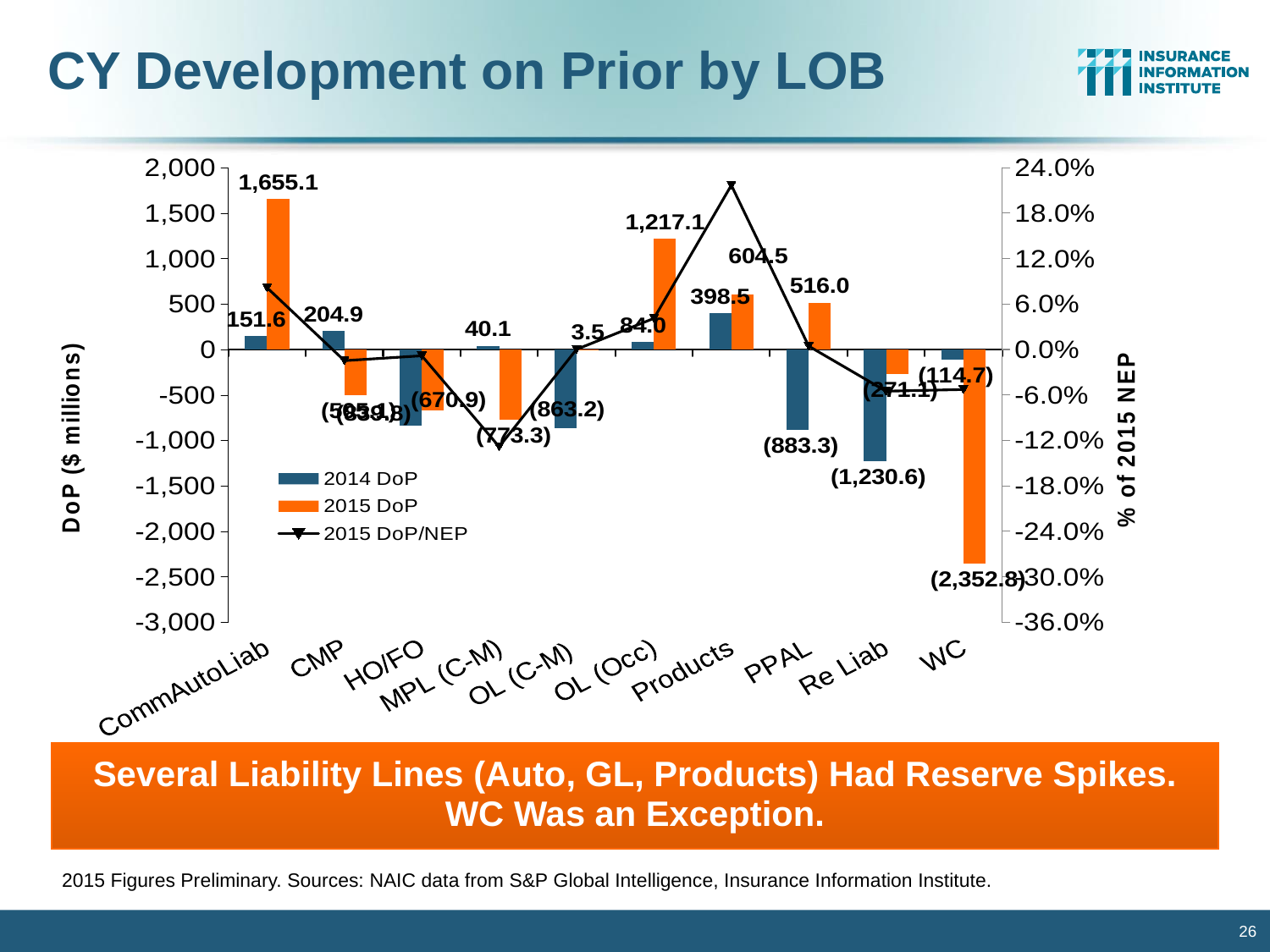
What is the 2014 DoP value for Re Liab? (1,230.6) What is the 2015 DoP value for OL (Occ)? 1,217.1 What is the difference between the 2015 DoP for CommAutoLiab and for OL (Occ)? 438.0 Which line of business has the highest 2015 DoP? CommAutoLiab What is the 2015 DoP value for CommAutoLiab? 1,655.1 Which line of business has the lowest 2015 DoP? WC How many series does the legend list? 3 What is the 2015 DoP value for WC? (2,352.8) Is the 2015 DoP/NEP value for Products greater or less than 18.0%? greater What is the 2014 DoP value for Products? 398.5 How many lines of business are shown on the x axis? 10 Which is larger, the 2015 DoP for Products or the 2015 DoP for PPAL? Products